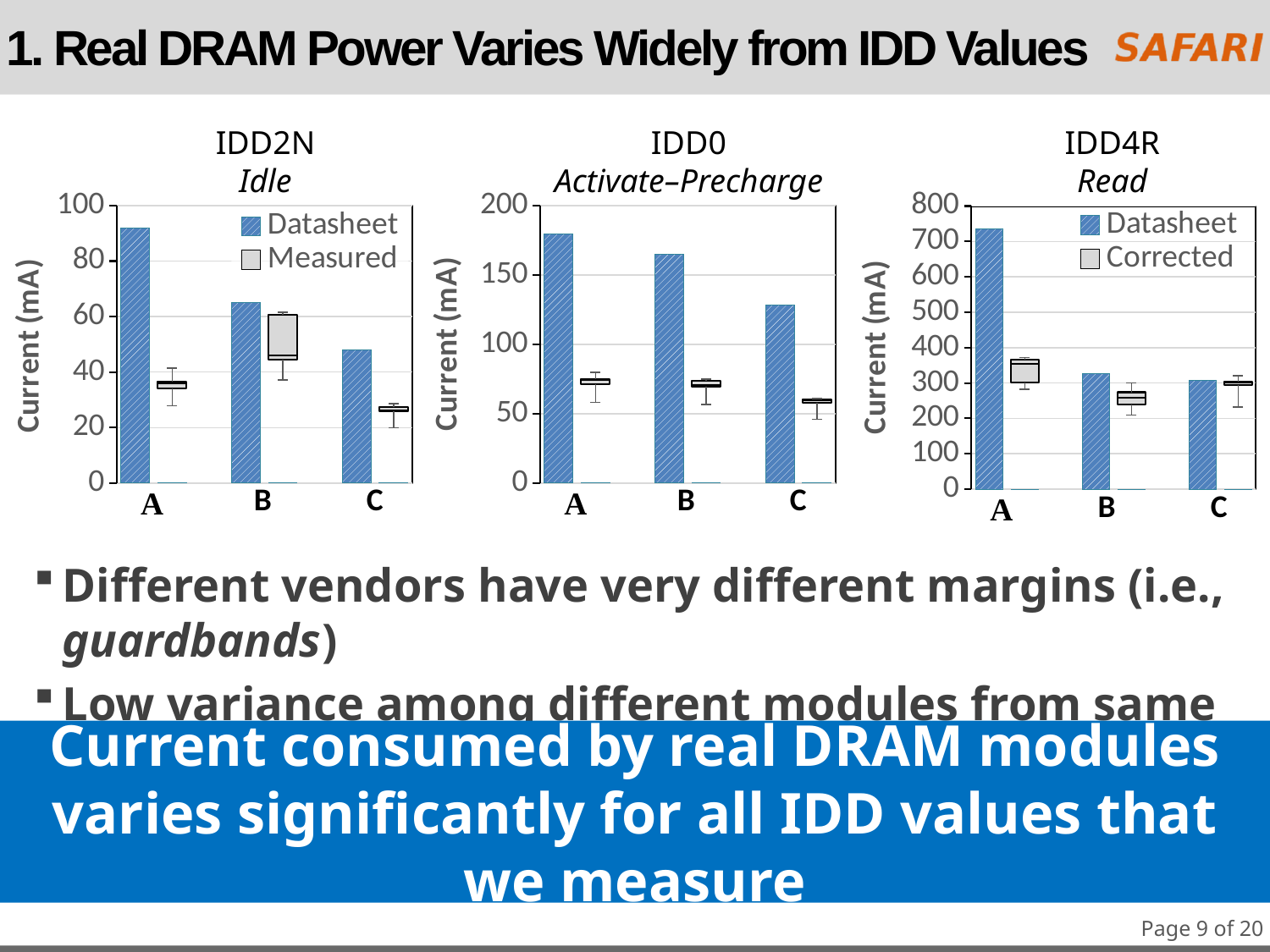
In the IDD2N Idle chart, is the Datasheet value for vendor A greater or less than 80? greater In the IDD2N Idle chart, which vendor has the highest Datasheet current? A How many series does the legend of the IDD4R Read chart list? 2 In the IDD0 Activate–Precharge chart, which vendor has the lowest Datasheet current? C In the IDD2N Idle chart, do the Datasheet values rise or fall from vendor A to vendor C? fall In the IDD0 Activate–Precharge chart, is the Datasheet value for vendor C greater or less than 150? less In the IDD4R Read chart, which vendor has the highest Datasheet current? A In the IDD2N Idle chart, is the Datasheet value for vendor C greater or less than 60? less How many vendors are shown on the x axis of the IDD2N Idle chart? 3 In the IDD0 Activate–Precharge chart, which is larger, the Datasheet value for vendor A or for vendor C? A